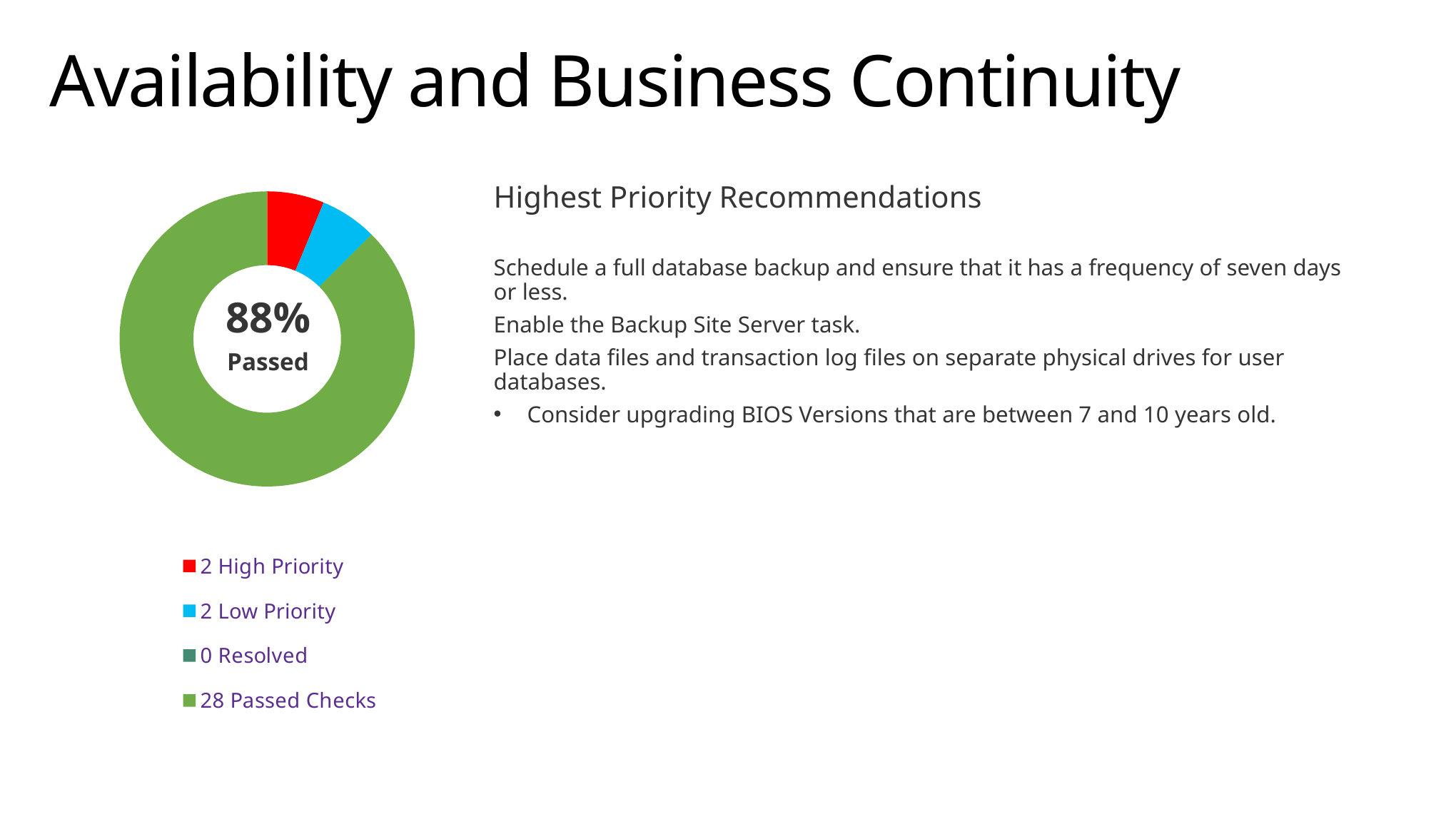
How many Resolved items does the legend show? 0 What is the difference between the number of Passed Checks and the number of High Priority items? 26 How many High Priority items does the legend show? 2 Which is larger, the number of Passed Checks or the number of Low Priority items? Passed Checks What kind of chart is shown on the slide? Donut (pie) chart How many Passed Checks does the legend show? 28 What percentage is shown in the centre of the donut chart? 88% How many Low Priority items does the legend show? 2 How many categories does the chart legend list? 4 Which category has the largest value in the chart? Passed Checks What colour represents High Priority in the chart? Red Which category has the smallest value in the chart? Resolved